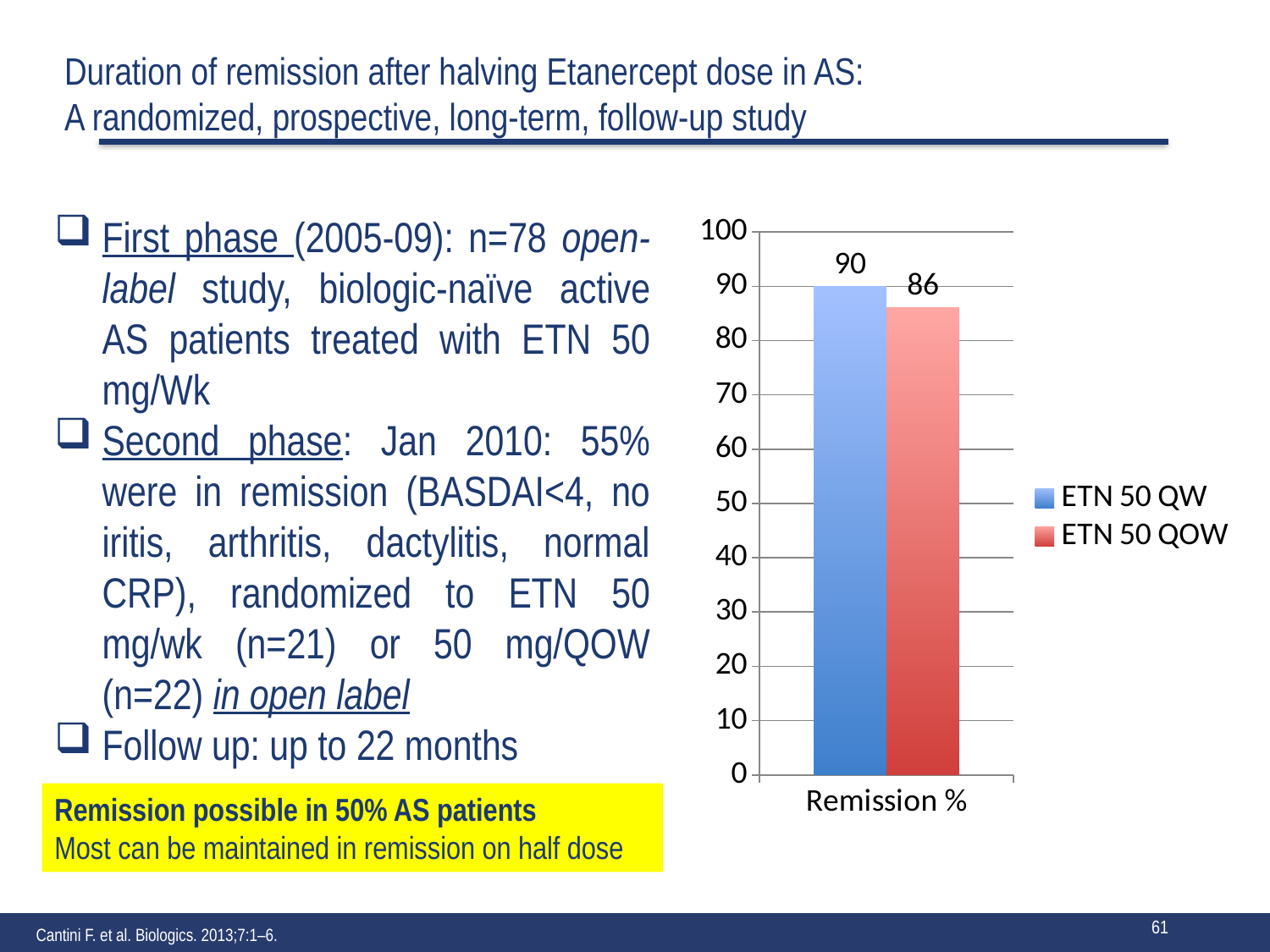
How many series does the legend list? 2 What is the Remission % value for ETN 50 QOW? 86 Which series has the lower Remission %? ETN 50 QOW What is the maximum value shown on the y axis of the chart? 100 Which series has the higher Remission %? ETN 50 QW What is the Remission % value for ETN 50 QW? 90 What kind of chart is shown on the slide? Bar chart Is the Remission % for ETN 50 QOW greater or less than 90? less Is the Remission % for ETN 50 QW greater or less than 80? greater What is the category label shown on the x axis of the chart? Remission % What colour is the bar for ETN 50 QOW? Red What is the difference in Remission % between ETN 50 QW and ETN 50 QOW? 4